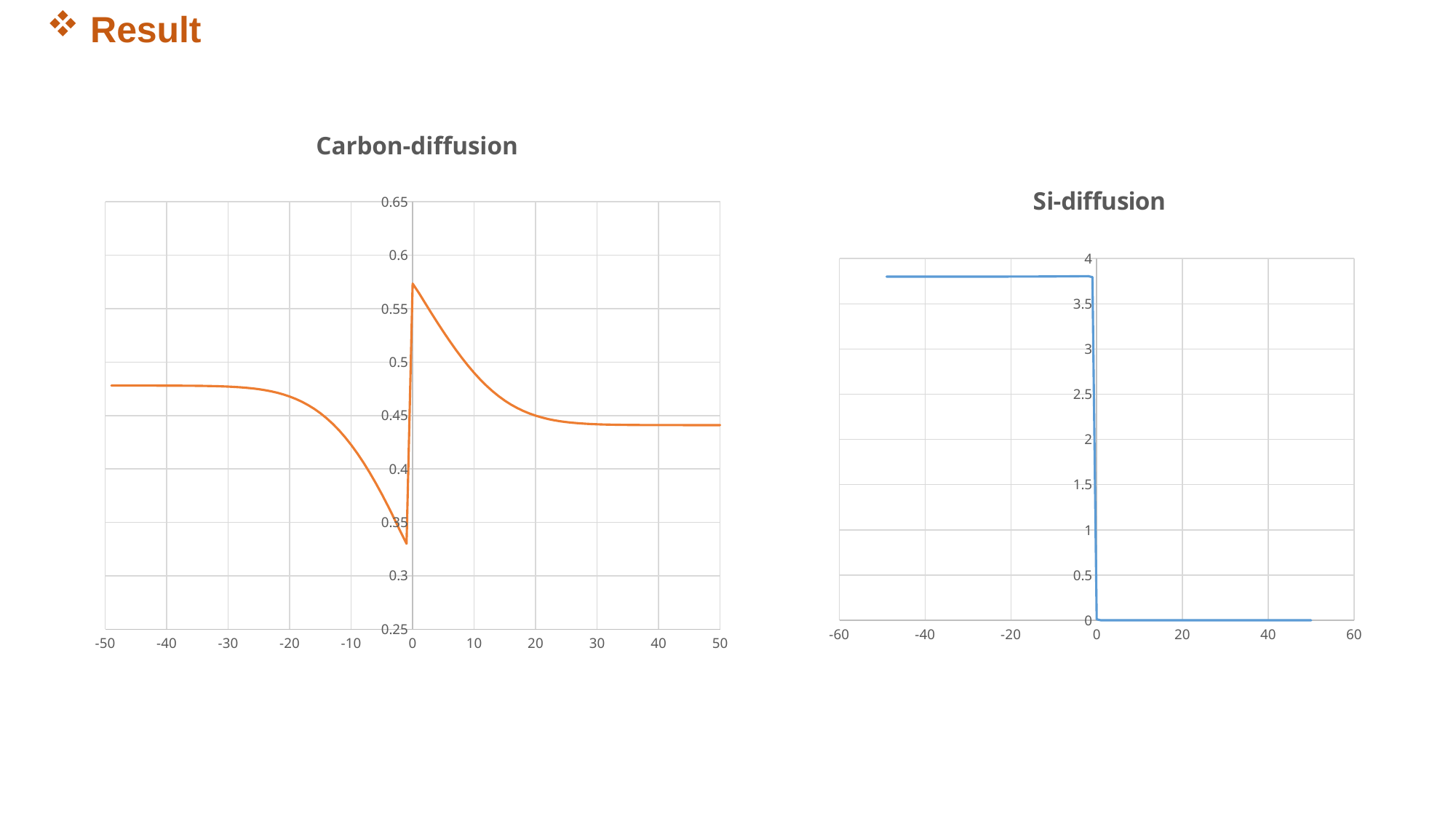
In the Carbon-diffusion chart, is the highest point of the line greater or less than 0.55? greater In the Si-diffusion chart, does the line rise or fall as x increases past 0? fall What colour is the line in the Si-diffusion chart? blue In the Si-diffusion chart, is the value at x = -40 greater or less than 3.5? greater What kind of chart is the Carbon-diffusion chart? line chart In the Carbon-diffusion chart, is the lowest point of the line greater or less than 0.35? less What kind of chart is the Si-diffusion chart? line chart How many charts are shown on the slide? 2